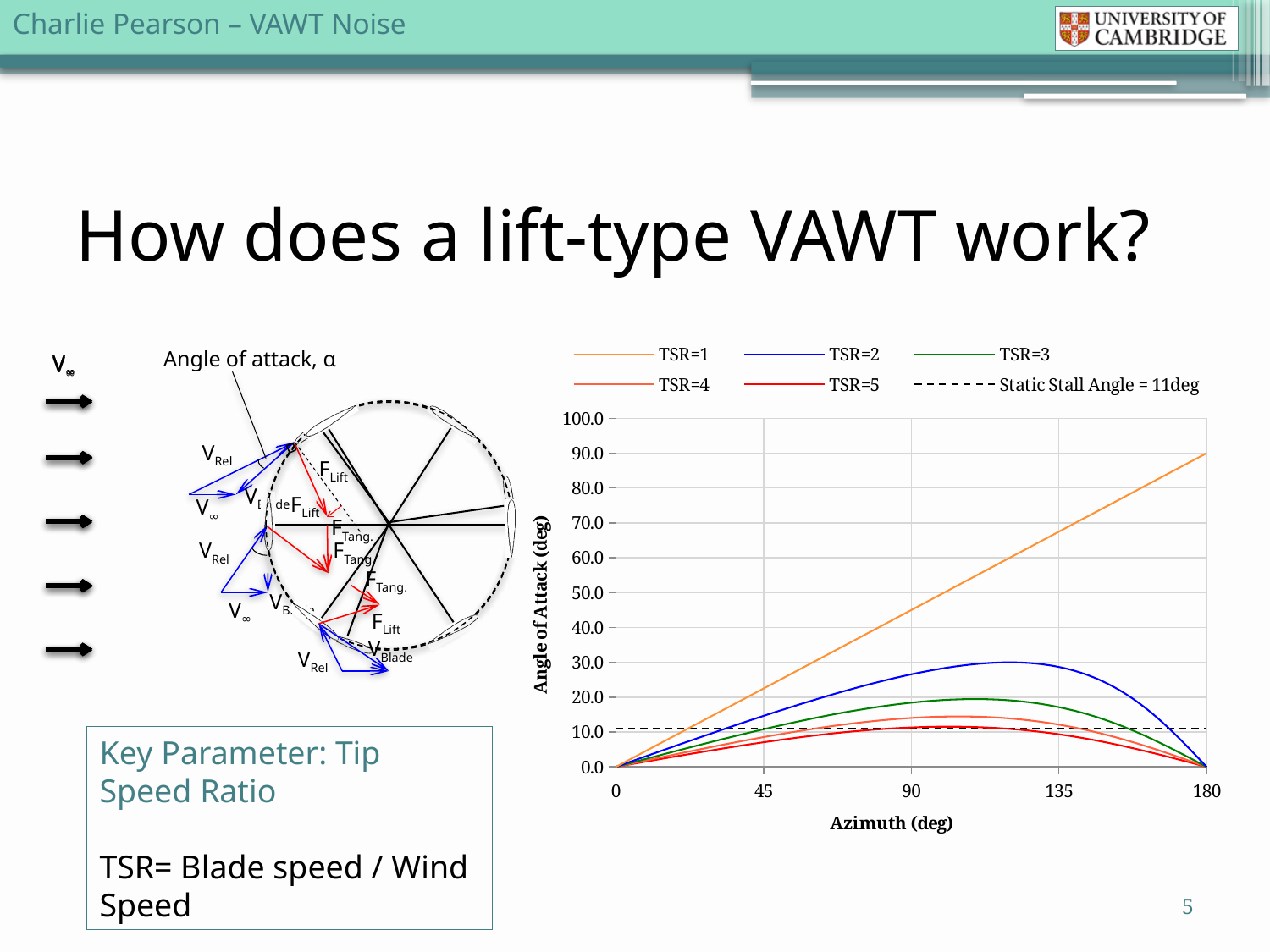
Is the peak angle of attack for TSR=2 greater or less than 20? greater Does the angle of attack for TSR=1 rise or fall as azimuth increases from 0 to 180 deg? rise According to the legend, what is the static stall angle shown by the dashed line? 11deg How many series does the chart legend list? 6 Which TSR series has the lowest peak angle of attack? TSR=5 What is the angle of attack for TSR=1 at an azimuth of 180 deg? 90.0 What type of chart is shown on the slide? line chart Which TSR series reaches the highest angle of attack? TSR=1 Is the peak angle of attack for TSR=5 greater or less than 20? less What is the angle of attack for TSR=2 at an azimuth of 0 deg? 0.0 What is the label of the x axis of the chart? Azimuth (deg) At an azimuth of 90 deg, which has the larger angle of attack, TSR=2 or TSR=5? TSR=2